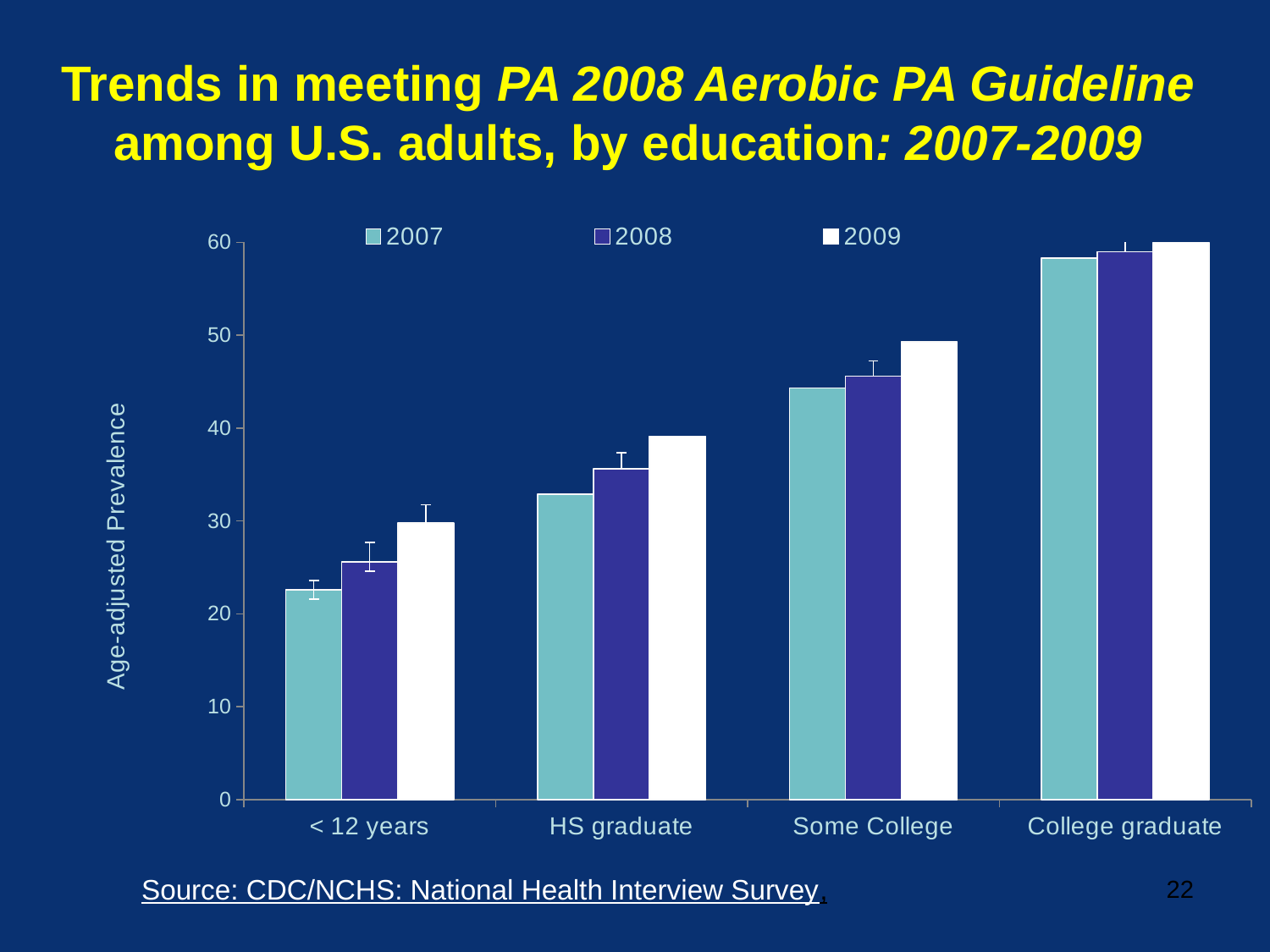
Which education category has the highest value for 2009? College graduate What is the label on the y axis? Age-adjusted Prevalence How many series does the legend list? 3 Is the 2009 value for HS graduate greater or less than 30? greater Which is larger, the 2008 value for HS graduate or the 2008 value for Some College? Some College Do the values rise or fall as education level increases from < 12 years to College graduate? rise Is the 2009 value for College graduate greater or less than 50? greater Is the 2007 value for Some College greater or less than 40? greater Which education category has the lowest value for 2007? < 12 years How many education categories are shown on the x axis? 4 What kind of chart is shown on the slide? bar chart